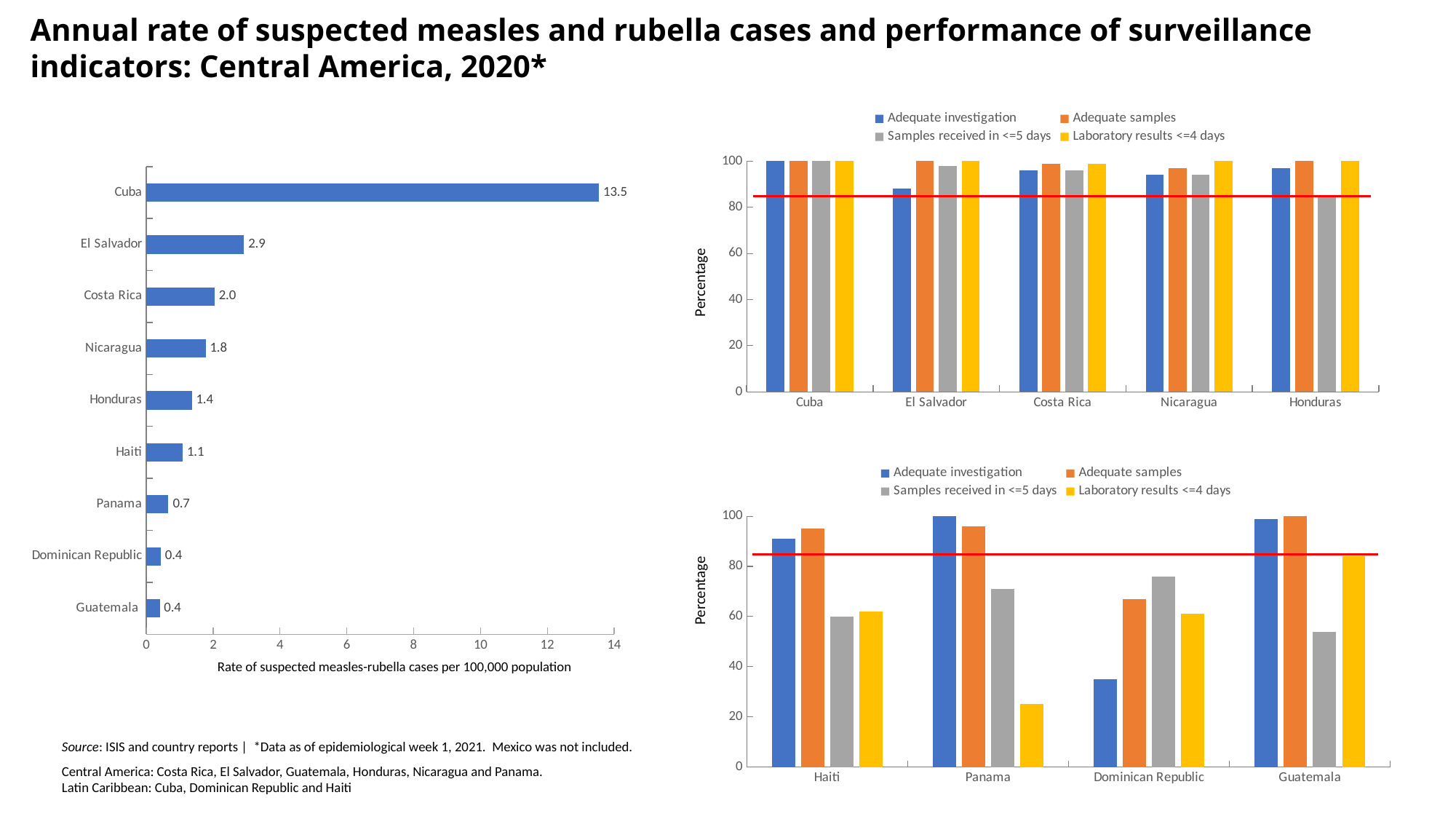
On the left chart, which has a higher value, Nicaragua or Honduras? Nicaragua On the left chart, what is the value for El Salvador? 2.9 On the top-right chart, is the Adequate investigation value for El Salvador greater or less than 80? greater How many series does the legend of the top-right chart list? 4 On the left chart, what is the difference between the values for Cuba and El Salvador? 10.6 On the bottom-right chart, which country has the lowest value for Laboratory results <=4 days? Panama On the bottom-right chart, is the Adequate investigation value for Dominican Republic greater or less than 40? less On the left chart, what is the rate of suspected measles-rubella cases per 100,000 population for Cuba? 13.5 On the left chart, which country has the highest rate of suspected measles-rubella cases? Cuba What kind of chart is the left chart? Bar chart How many countries are shown on the left chart? 9 How many countries are shown on the bottom-right chart? 4